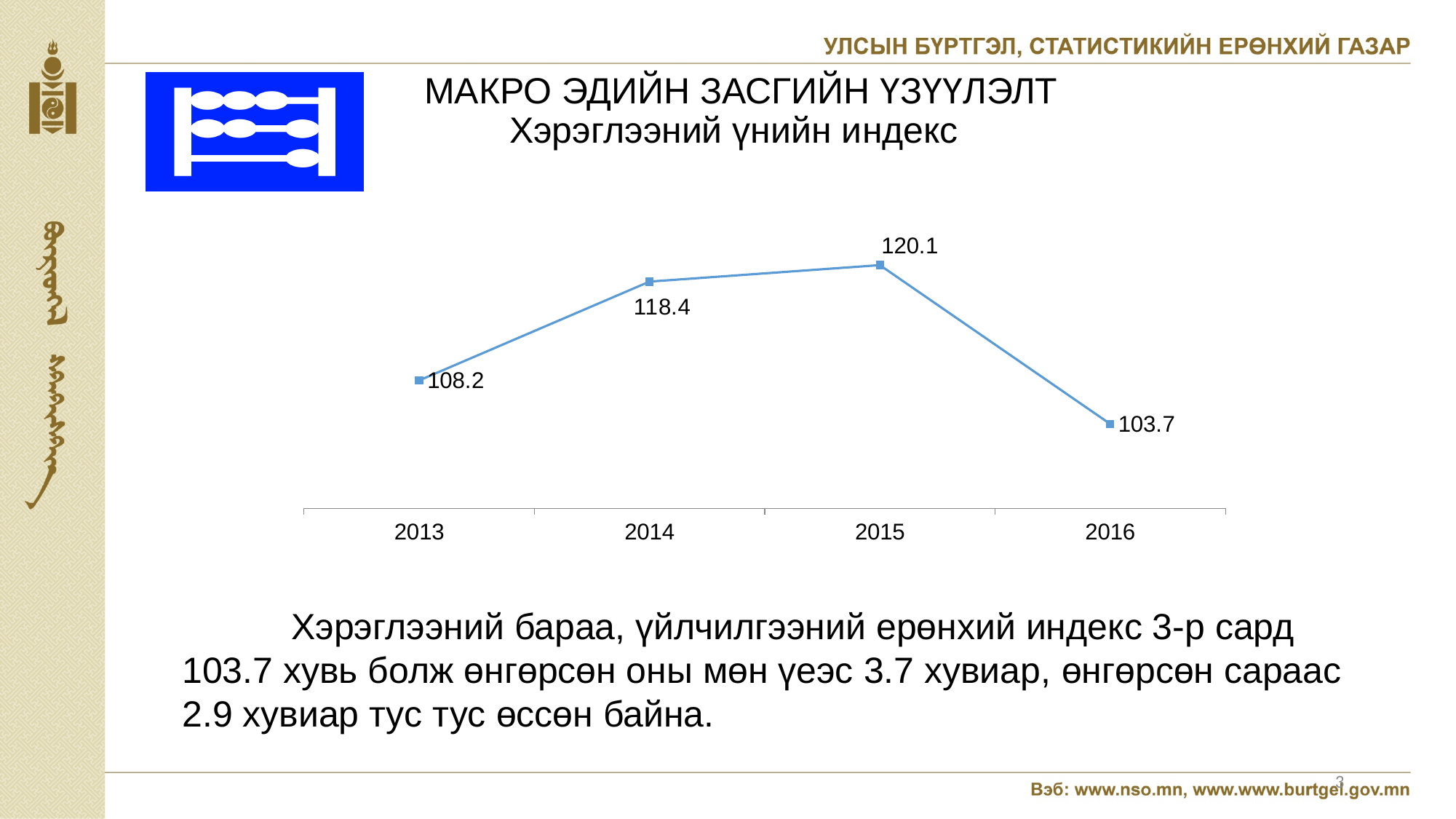
What is the value for 2015? 120.1 Which year has the highest value? 2015 Which is larger, the value for 2014 or the value for 2016? 2014 Which year has the lowest value? 2016 What is the difference between the values for 2014 and 2013? 10.2 What is the value for 2013? 108.2 What is the value for 2016? 103.7 How many years are plotted on the chart? 4 Does the value rise or fall from 2015 to 2016? fall What kind of chart is shown on the slide? line chart Does the value rise or fall from 2013 to 2014? rise What is the difference between the values for 2015 and 2016? 16.4